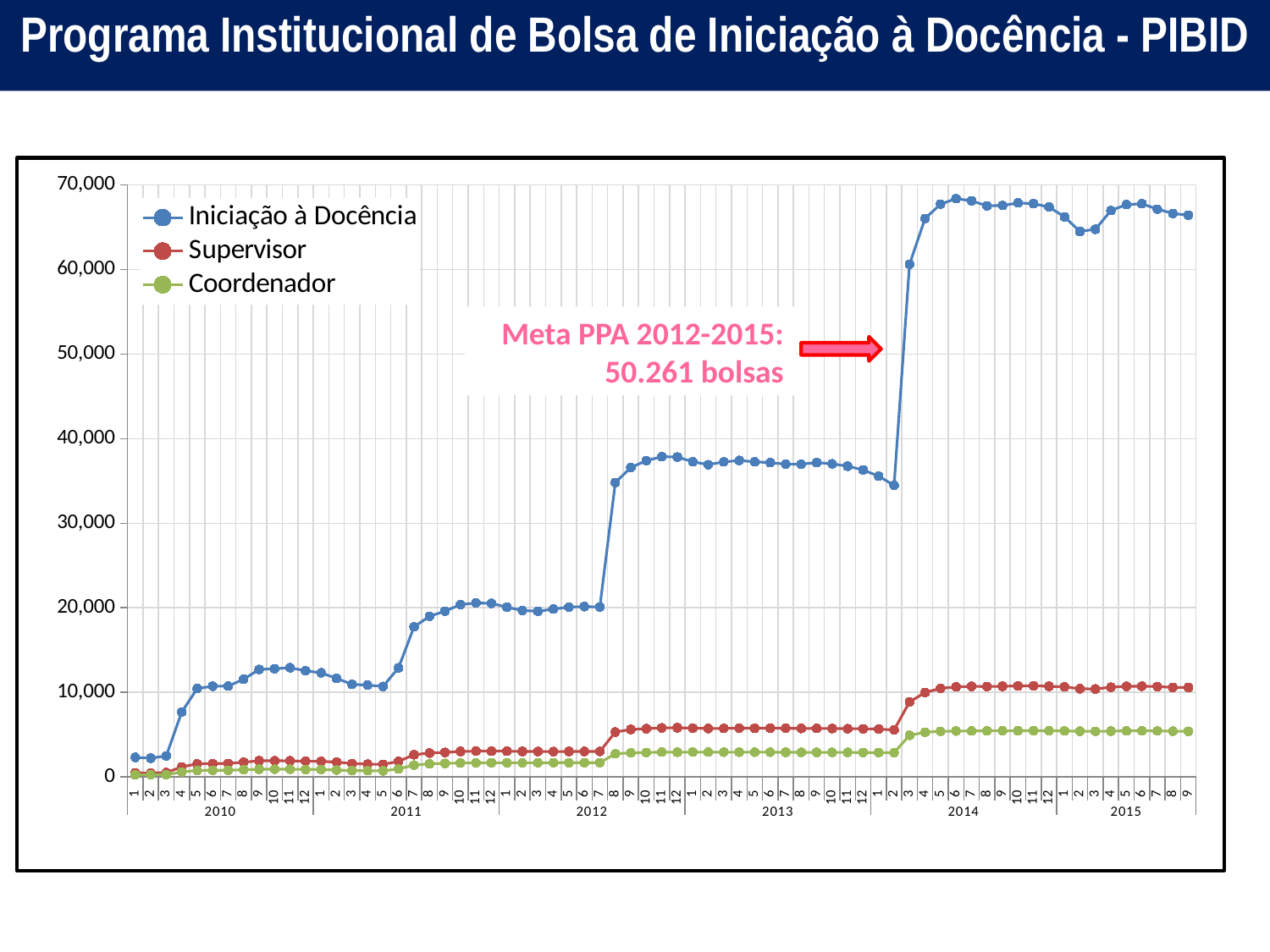
How many series does the legend list? 3 How many years are labelled along the x axis? 6 Which series has the lowest values throughout the chart? Coordenador Is the value for Coordenador in month 9 of 2015 greater or less than 10,000? less In month 9 of 2015, which is larger: Supervisor or Coordenador? Supervisor Which series has the highest values throughout the chart? Iniciação à Docência Is the value for Iniciação à Docência in month 1 of 2010 greater or less than 10,000? less What kind of chart is shown on the slide? line chart Is the value for Iniciação à Docência in month 9 of 2015 greater or less than 60,000? greater Which series are listed in the legend? Iniciação à Docência, Supervisor, Coordenador Does the Iniciação à Docência series overall rise or fall from 2010 to 2015? rise